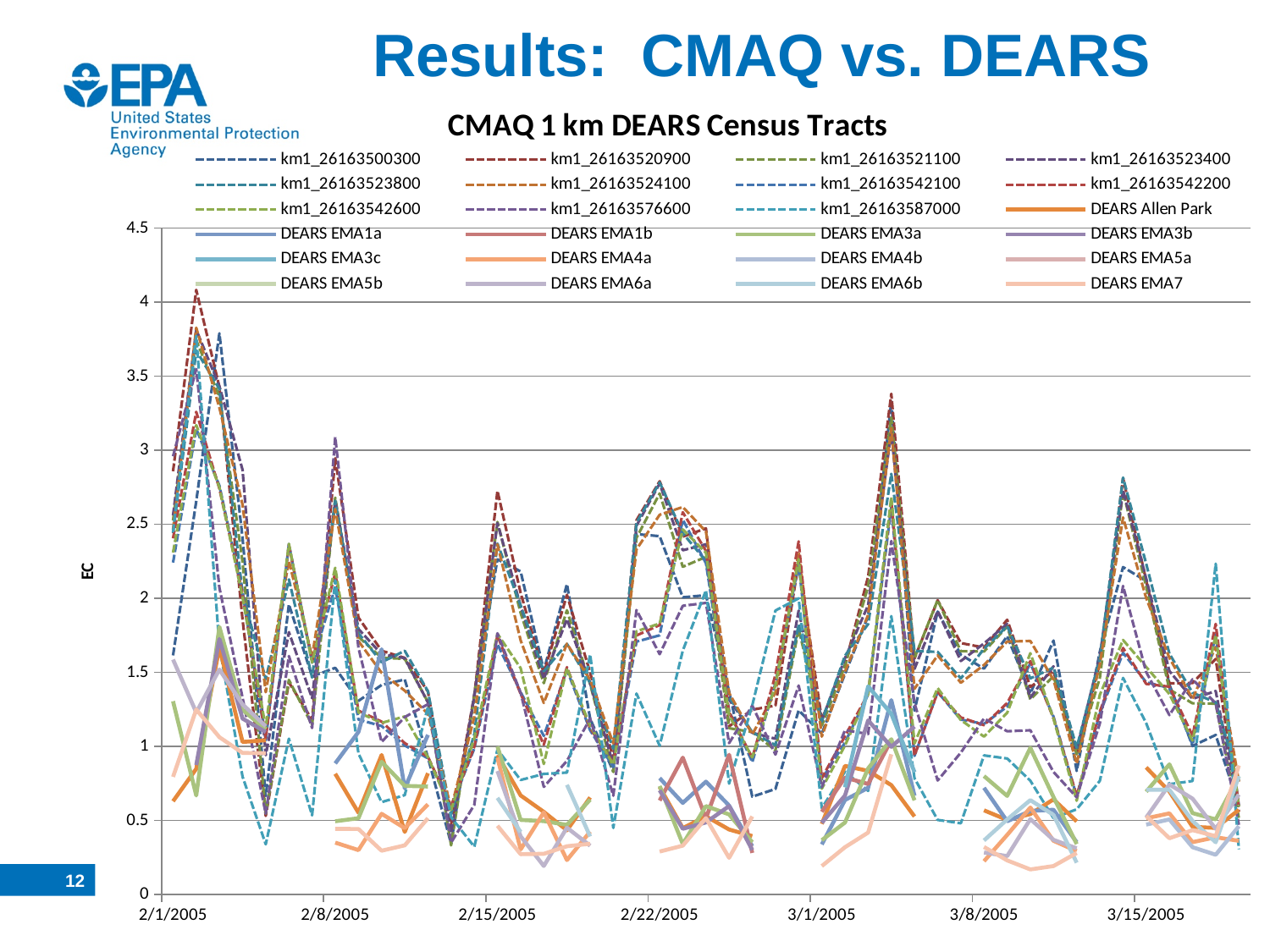
Is the highest peak plotted on the chart greater or less than 4.5? less What type of chart is shown on the slide? line chart What is the label on the vertical axis of the chart? EC What is the title of the chart? CMAQ 1 km DEARS Census Tracts What is the first date label on the horizontal axis? 2/1/2005 How many series in the legend have names beginning with "DEARS"? 13 How many series does the chart legend list? 24 Is the highest peak plotted on the chart greater or less than 3.5? greater What is the last date label on the horizontal axis? 3/15/2005 What is the highest value shown on the vertical axis? 4.5 How many series in the legend have names beginning with "km1_"? 11 How many date labels are shown along the horizontal axis? 7